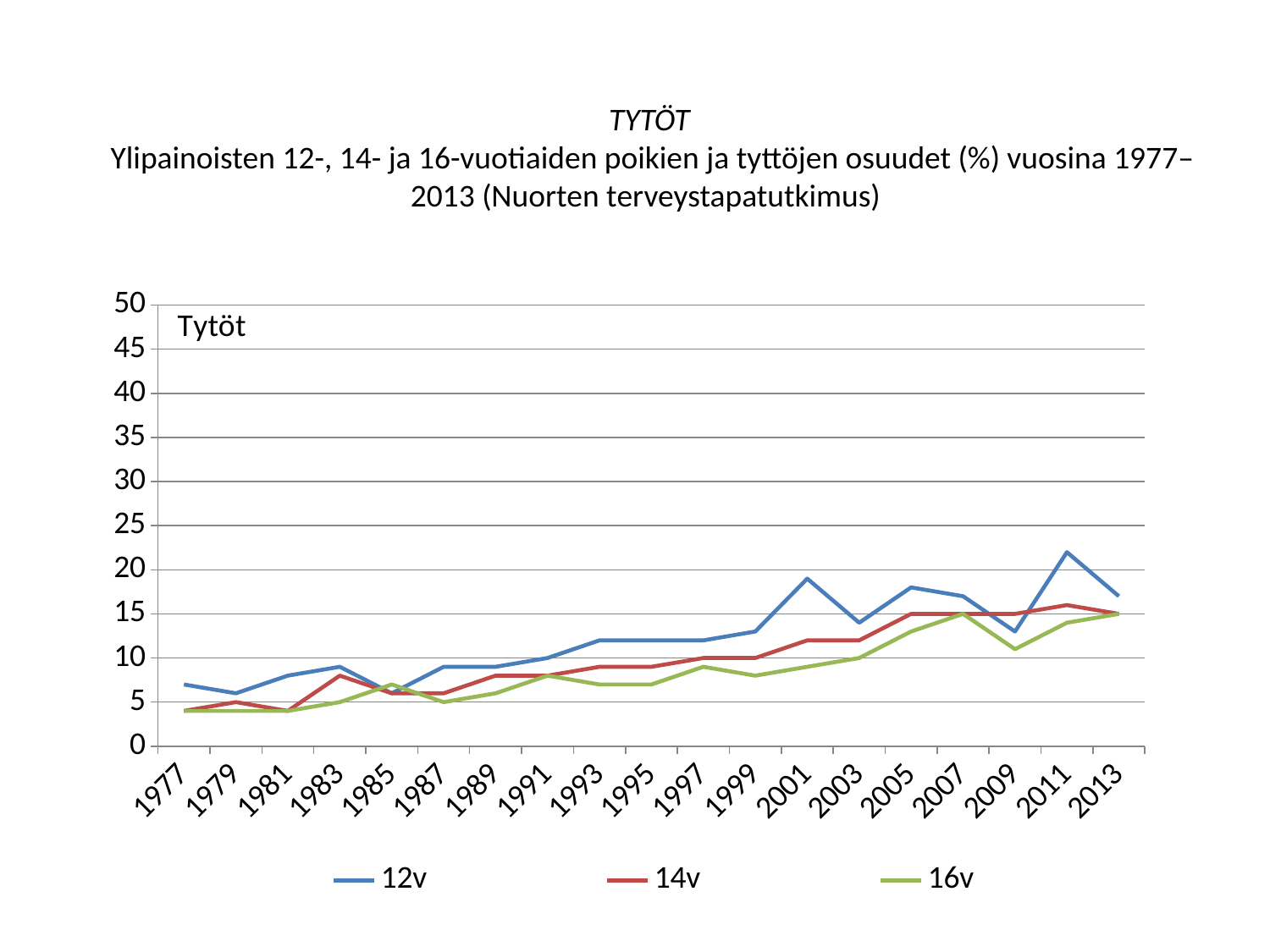
In 2001, which series has the larger value, 12v or 16v? 12v How many series does the legend list? 3 Which colour is used for the 16v series? green Is the value for 16v in 1977 greater or less than 5? less In which year does the 12v series reach its highest value? 2011 Is the value for 12v in 2001 greater or less than 20? less Is the value for 12v in 2011 greater or less than 20? greater Does the 12v series generally rise or fall from 1977 to 2013? rise What kind of chart is shown on the slide? line chart In 2011, which series has the larger value, 12v or 14v? 12v How many years are labelled along the x axis? 19